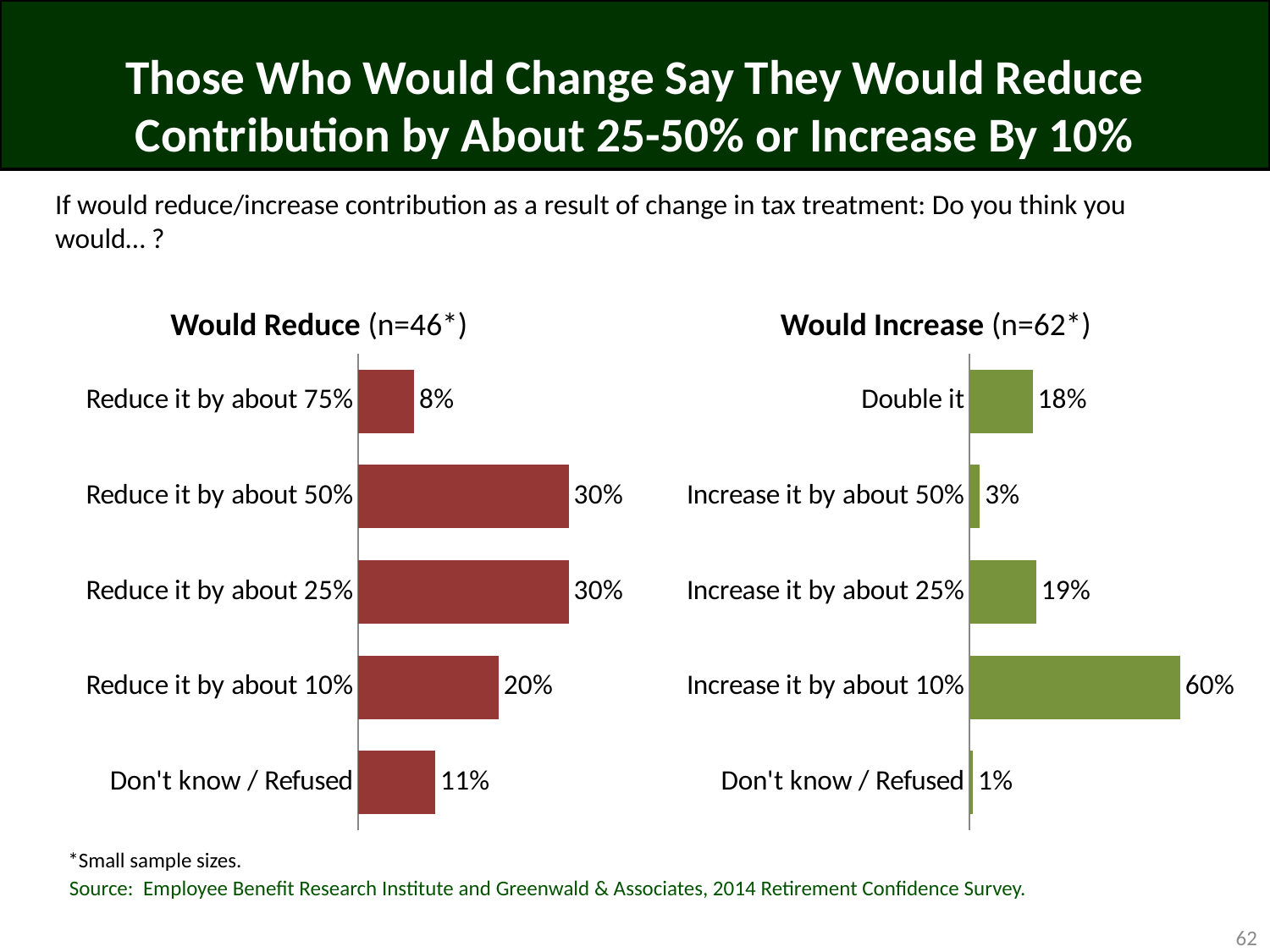
In the 'Would Reduce' chart, which category has the lowest value? Reduce it by about 75% What kind of chart is the 'Would Increase' chart? Bar chart In the 'Would Increase' chart, what is the difference between 'Increase it by about 10%' and 'Increase it by about 25%'? 41% In the 'Would Reduce' chart, which is larger: 'Reduce it by about 75%' or 'Don't know / Refused'? Don't know / Refused In the 'Would Reduce' chart, what percentage would reduce it by about 10%? 20% In the 'Would Reduce' chart, what is the difference between 'Reduce it by about 50%' and 'Reduce it by about 10%'? 10% In the 'Would Increase' chart, which category has the lowest value? Don't know / Refused What is the sample size shown for the 'Would Increase' chart? n=62* How many categories does the 'Would Reduce' chart show? 5 What colour are the bars in the 'Would Reduce' chart? Red In the 'Would Increase' chart, which category has the highest value? Increase it by about 10% In the 'Would Increase' chart, what percentage would double it? 18%